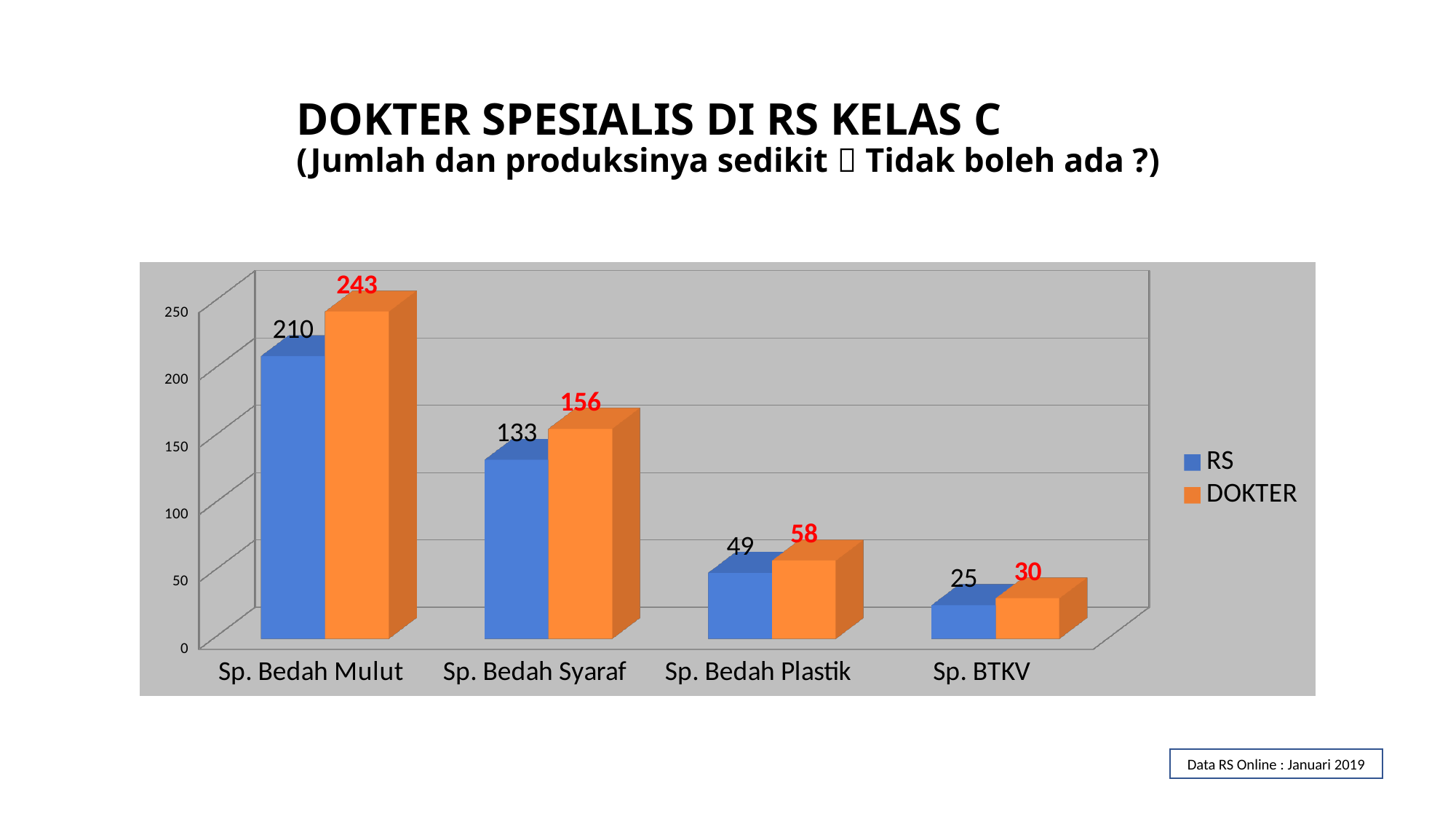
Which is larger for Sp. Bedah Plastik, the RS value or the DOKTER value? DOKTER What is the RS value for Sp. Bedah Plastik? 49 How many series does the legend list? 2 What is the difference between the DOKTER and RS values for Sp. Bedah Mulut? 33 What is the DOKTER value for Sp. BTKV? 30 Which category has the lowest RS value? Sp. BTKV How many categories are shown on the x axis? 4 Do the RS values rise or fall from left to right along the x axis? Fall What is the DOKTER value for Sp. Bedah Syaraf? 156 Which category has the highest DOKTER value? Sp. Bedah Mulut What is the RS value for Sp. Bedah Mulut? 210 What kind of chart is shown on the slide? Bar chart